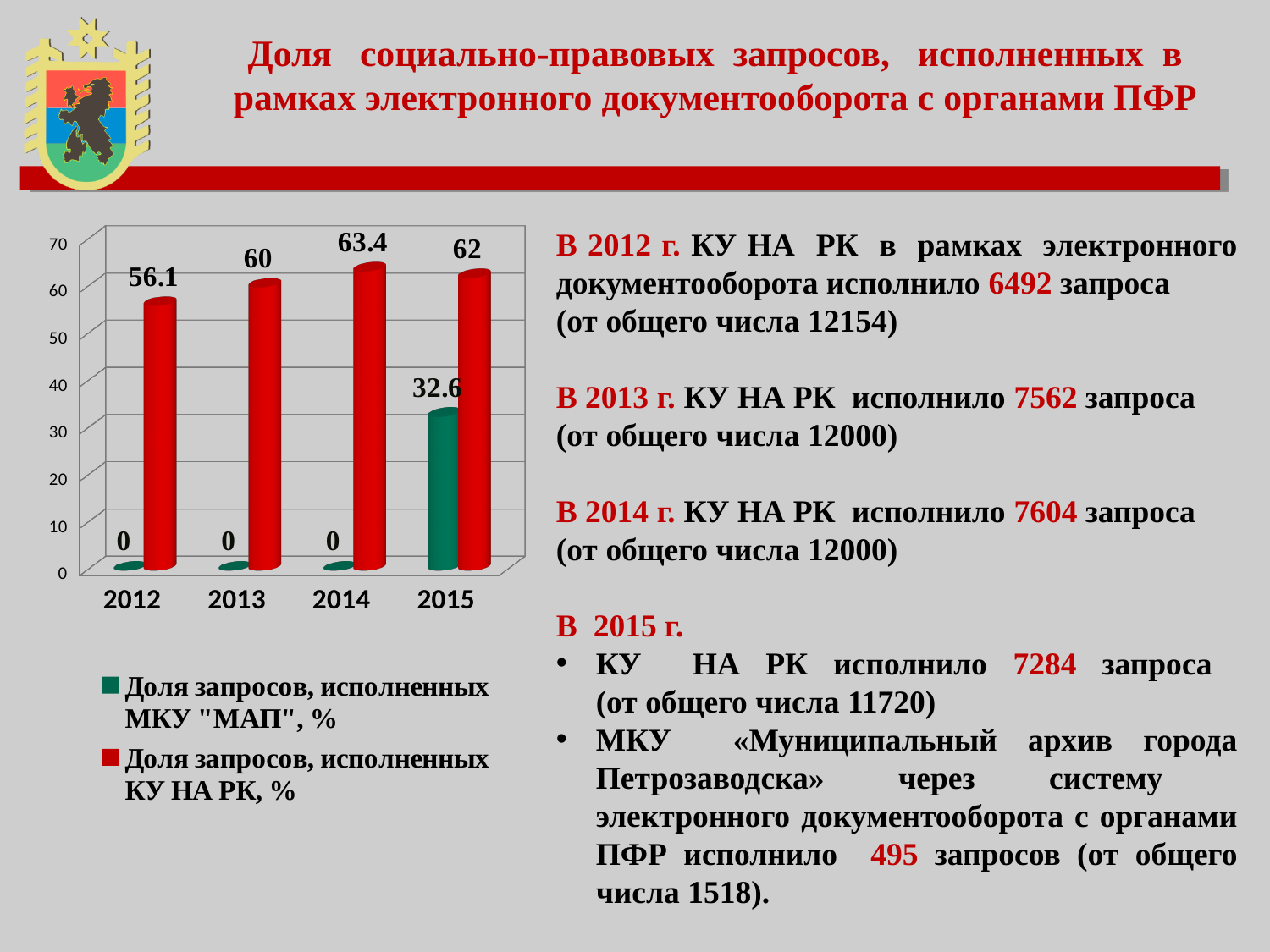
In which year is the value for КУ НА РК the highest? 2014 What is the value for МКУ "МАП" in 2013? 0 Which is larger in 2015: the value for КУ НА РК or the value for МКУ "МАП"? КУ НА РК What is the difference between the КУ НА РК values for 2014 and 2012? 7.3 How many years are shown on the x axis? 4 How many series does the legend list? 2 Which colour represents the series "Доля запросов, исполненных КУ НА РК, %"? Red In which year is the value for КУ НА РК the lowest? 2012 What is the value for КУ НА РК in 2012? 56.1 What kind of chart is shown on the slide? Bar chart What is the value for КУ НА РК in 2014? 63.4 What is the value for МКУ "МАП" in 2015? 32.6